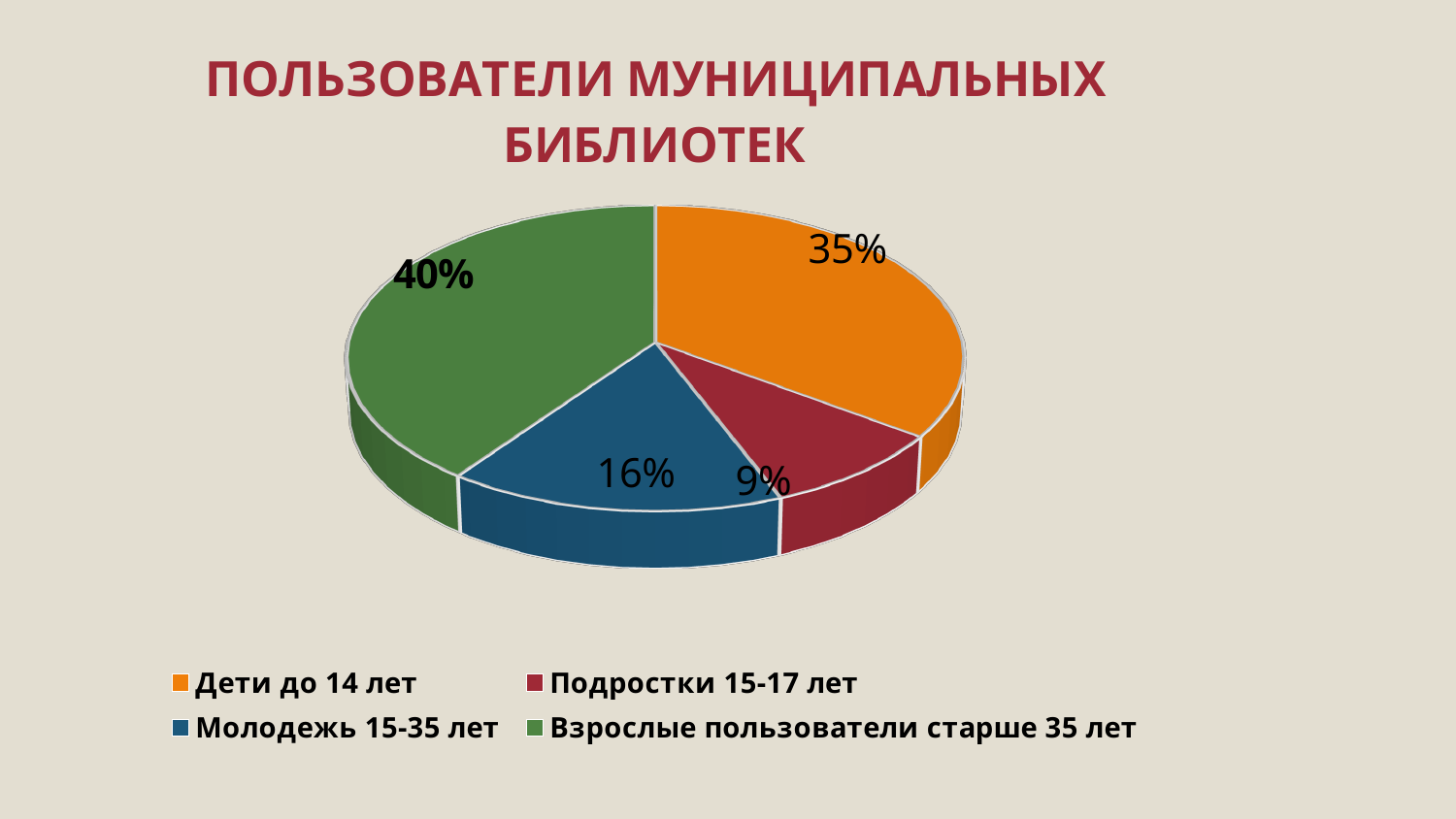
What share of municipal library users are Подростки 15-17 лет? 9% What is the difference in percentage points between Молодежь 15-35 лет and Подростки 15-17 лет? 7 What share of municipal library users are Дети до 14 лет? 35% Which user group has the smallest share of the pie? Подростки 15-17 лет What type of chart is shown on the slide? Pie chart How many user groups are shown in the pie chart? 4 Which group has a larger share: Дети до 14 лет or Молодежь 15-35 лет? Дети до 14 лет Which user group has the largest share of the pie? Взрослые пользователи старше 35 лет What is the difference in percentage points between Взрослые пользователи старше 35 лет and Дети до 14 лет? 5 What is the title of the chart? ПОЛЬЗОВАТЕЛИ МУНИЦИПАЛЬНЫХ БИБЛИОТЕК What share of municipal library users are Молодежь 15-35 лет? 16% What share of municipal library users are Взрослые пользователи старше 35 лет? 40%